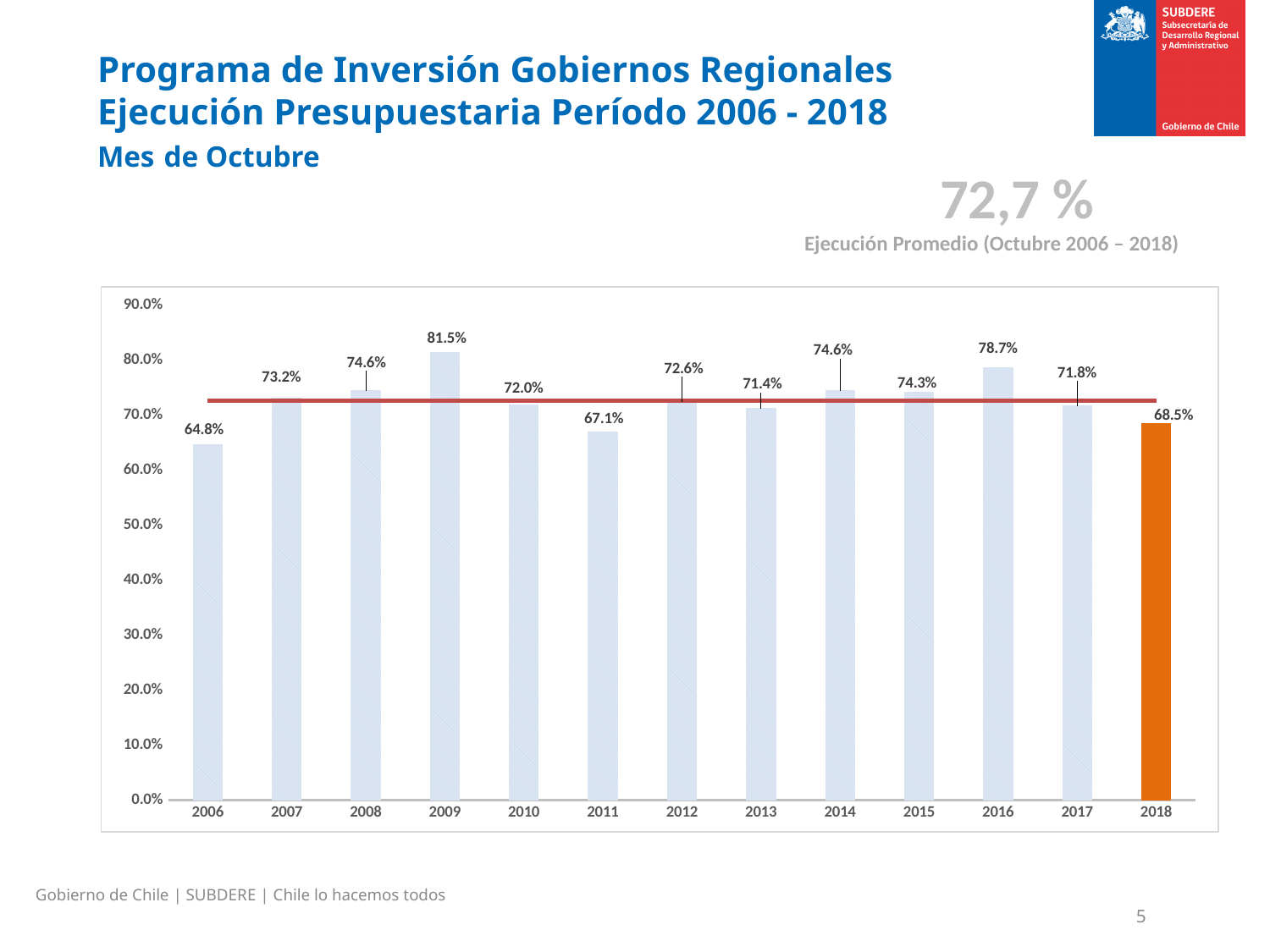
What is the difference between the values for 2009 and 2006? 16.7% How many years are shown on the x axis? 13 Which year has the highest value? 2009 Is the value for 2011 greater or less than 70.0%? less What kind of chart is shown? bar chart What is the value for 2018? 68.5% What average execution value is shown above the chart? 72,7 % Which year has the lowest value? 2006 Which year's bar is coloured orange? 2018 What is the value for 2011? 67.1% Which is larger, the value for 2016 or the value for 2017? 2016 What is the value for 2009? 81.5%